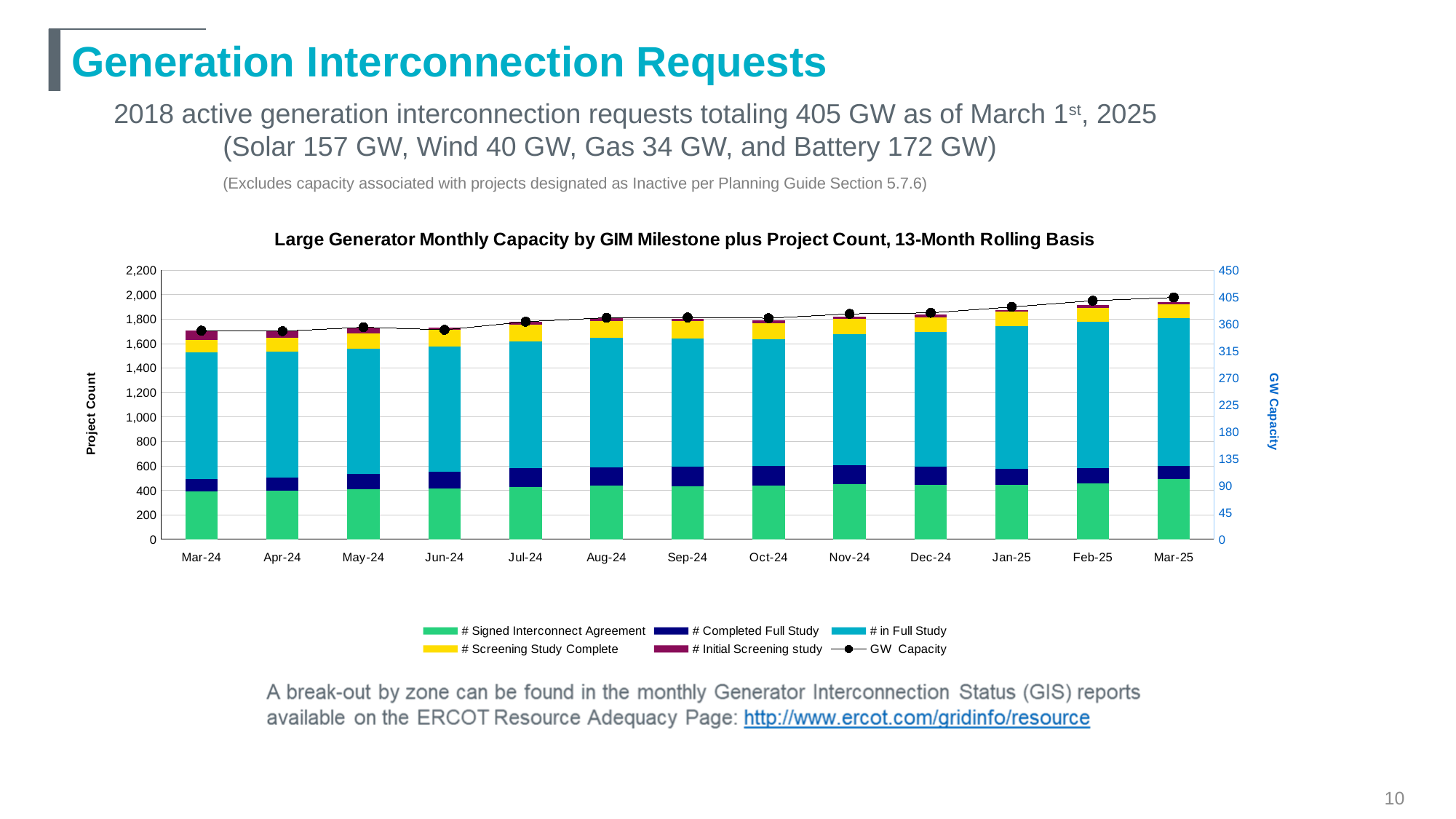
Which month has the highest GW Capacity value? Mar-25 How many months are shown on the x axis of the chart? 13 Does the GW Capacity line rise or fall from Mar-24 to Mar-25? Rises Is the total project count for Mar-25 greater or less than 1,800? greater Is the total project count larger in Mar-25 or in Mar-24? Mar-25 What is the title of the chart? Large Generator Monthly Capacity by GIM Milestone plus Project Count, 13-Month Rolling Basis What is the GW Capacity value for Mar-25? 405 GW What kind of chart is shown on the slide? Stacked bar chart with a line How many series does the chart legend list? 6 What is the label of the right-hand vertical axis? GW Capacity Is the GW Capacity value for Mar-24 greater or less than 405? less Is the total project count for Mar-24 greater or less than 1,800? less